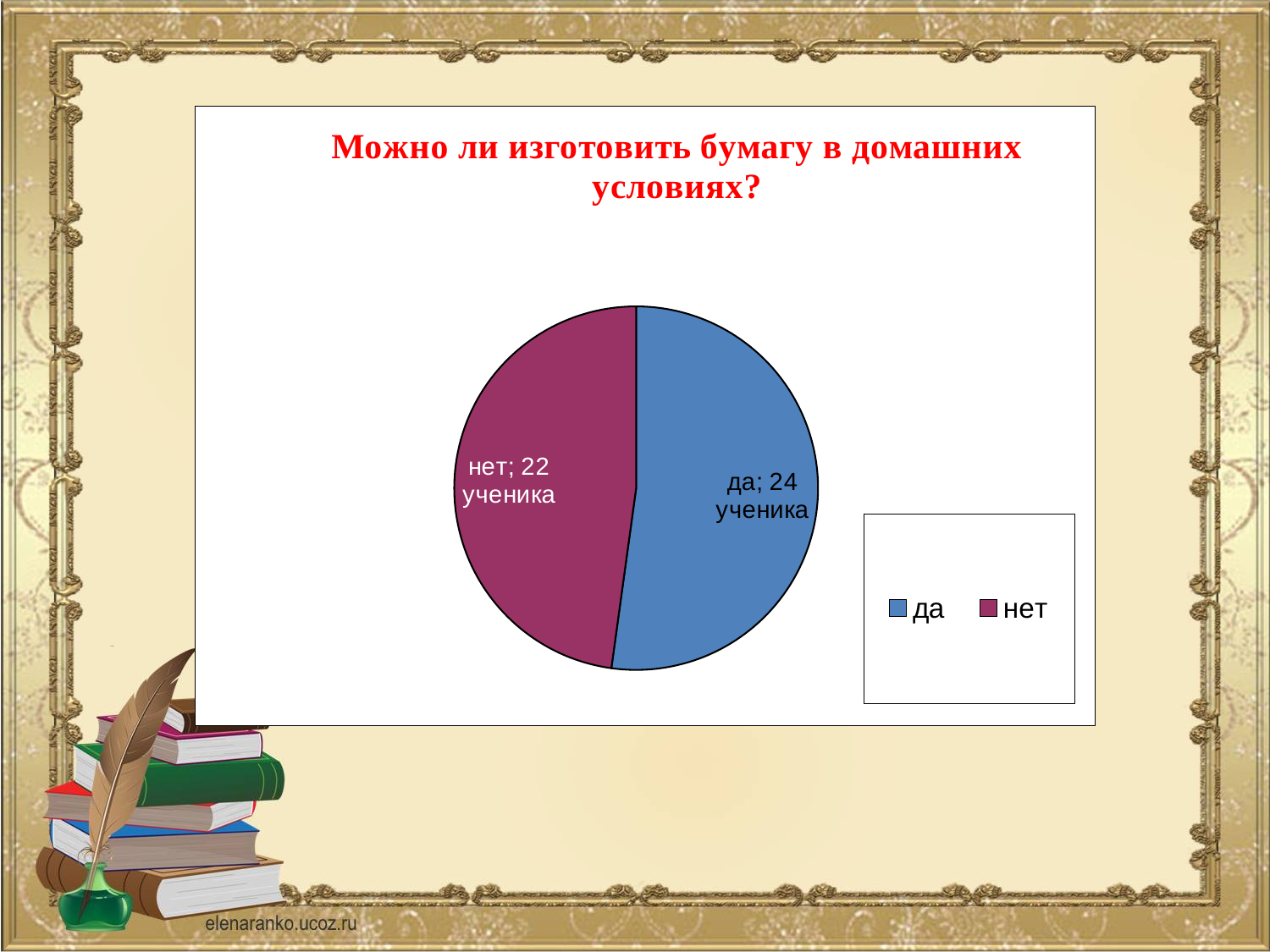
What is the total number of students represented in the pie chart? 46 How many more students answered "да" than "нет"? 2 Which answer has the larger slice of the pie chart? да What kind of chart is shown on the slide? pie chart What is the title of the chart on the slide? Можно ли изготовить бумагу в домашних условиях? Which is larger: the number of students who answered "да" or the number who answered "нет"? да How many entries does the legend of the pie chart list? 2 How many students answered "нет" in the pie chart? 22 ученика How many slices does the pie chart have? 2 How many students answered "да" in the pie chart? 24 ученика Which answer has the smaller slice of the pie chart? нет What colour is the "да" slice in the pie chart? blue